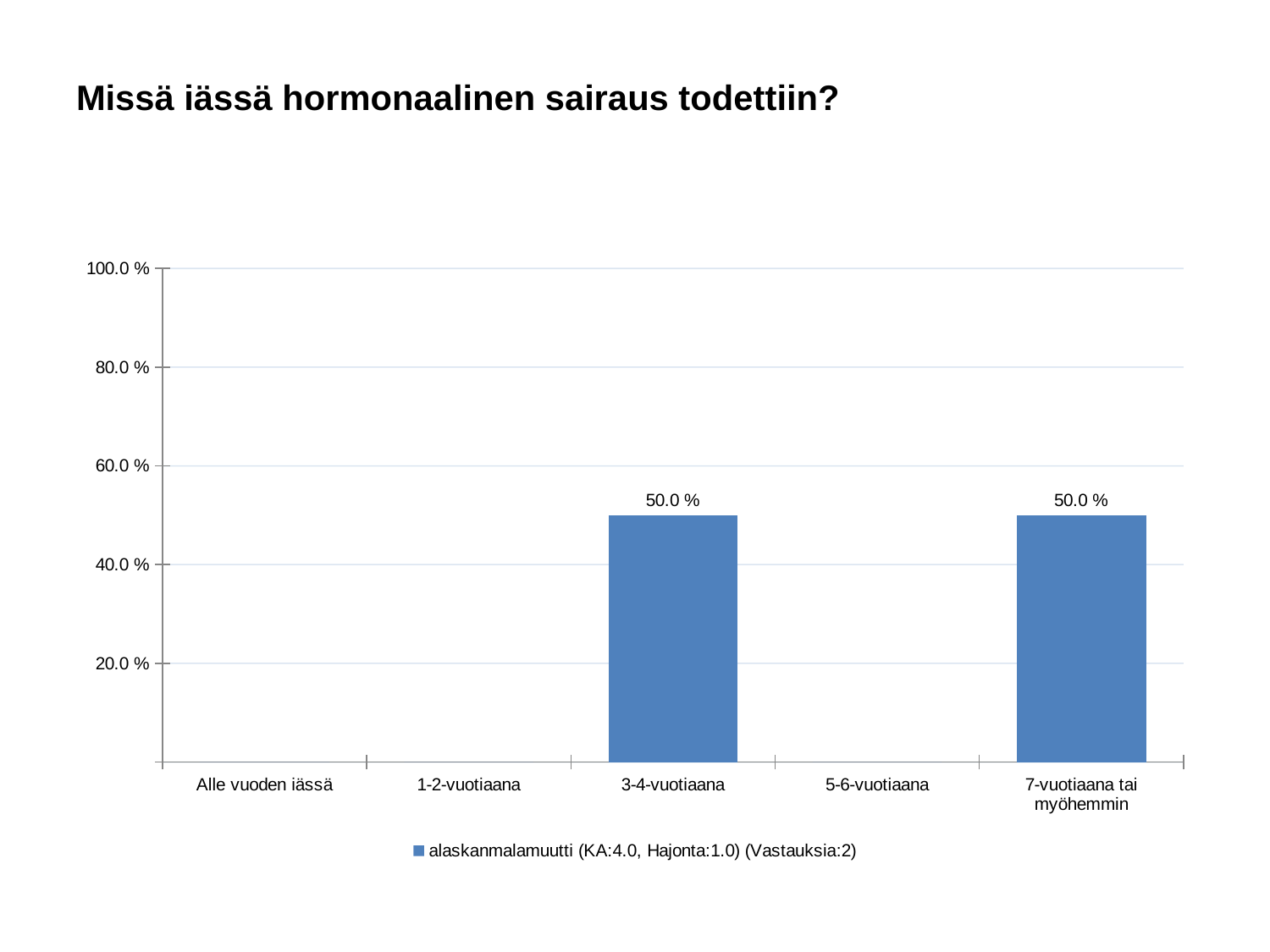
What kind of chart is shown on the slide? bar chart What is the value for 3-4-vuotiaana? 50.0 % What is the title of the chart? Missä iässä hormonaalinen sairaus todettiin? How many series does the legend list? 1 What is the value for 7-vuotiaana tai myöhemmin? 50.0 % What is the difference between the values for 3-4-vuotiaana and 7-vuotiaana tai myöhemmin? 0.0 % What series name is shown in the legend? alaskanmalamuutti (KA:4.0, Hajonta:1.0) (Vastauksia:2) How many age categories are shown on the x axis? 5 Is the value for 7-vuotiaana tai myöhemmin greater or less than 60.0 %? less Which is larger, the value for 3-4-vuotiaana or the value for 1-2-vuotiaana? 3-4-vuotiaana Is the value for 3-4-vuotiaana greater or less than 40.0 %? greater How many categories have a visible bar? 2